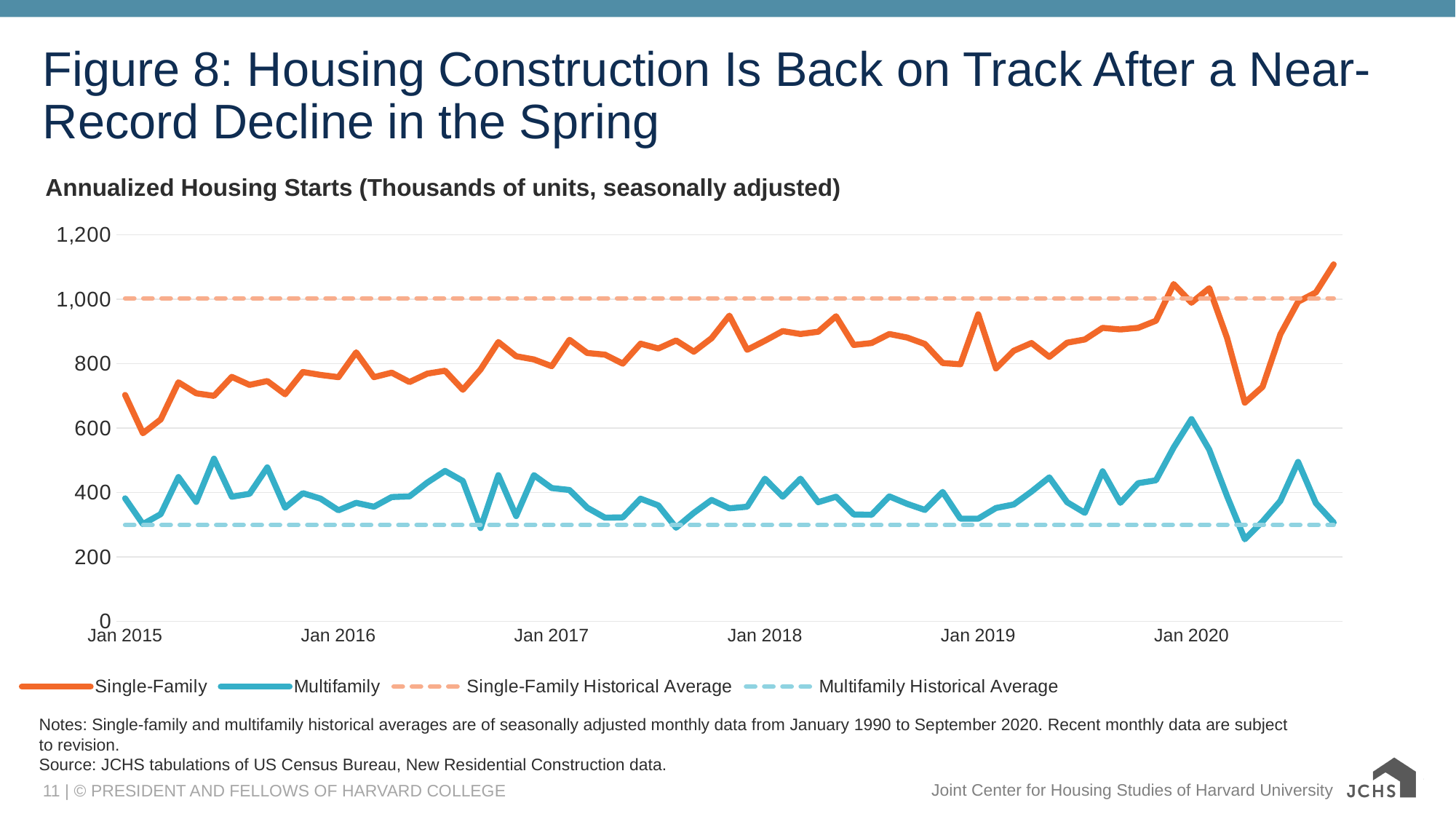
What kind of chart is shown on the slide? Line chart Is the Single-Family Historical Average line greater or less than 800? greater Which series is drawn as a solid orange line? Single-Family Does the Single-Family series generally rise or fall from Jan 2015 to Jan 2020? Rise Is the Multifamily Historical Average line greater or less than 400? less Is the peak Multifamily value in early 2020 greater or less than 600? greater What is the subtitle describing the measure plotted on the chart? Annualized Housing Starts (Thousands of units, seasonally adjusted) How many series does the legend list? 4 Which series has higher values throughout the chart, Single-Family or Multifamily? Single-Family